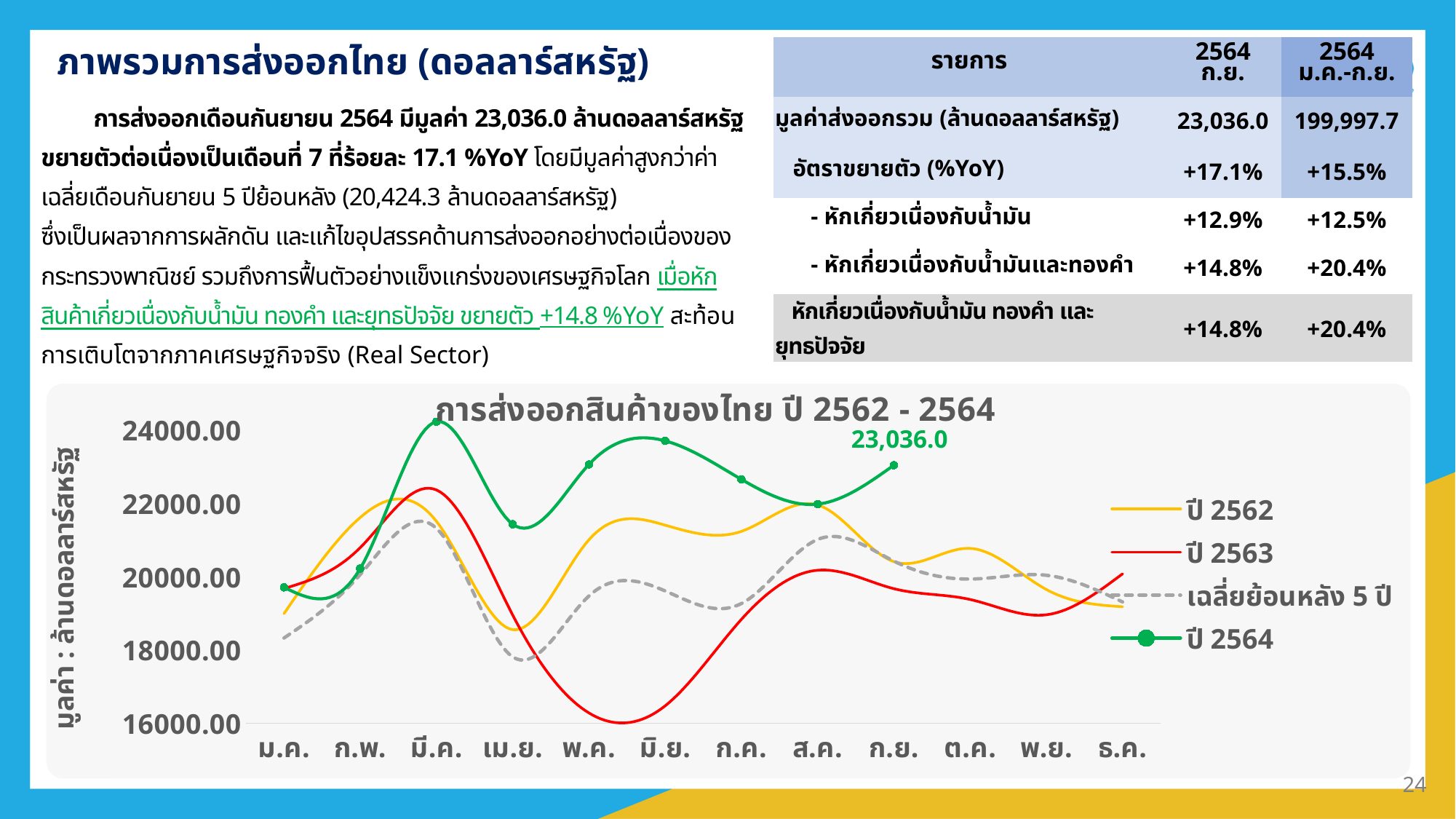
Is the value for ปี 2562 in เม.ย. greater or less than 20000? less What is the title of the chart? การส่งออกสินค้าของไทย ปี 2562 - 2564 Is the value for ปี 2564 in มี.ค. greater or less than 22000? greater In which month does the ปี 2564 series reach its highest value? มี.ค. What is the value for ปี 2564 in ก.ย. according to the data label on the chart? 23,036.0 In ก.ย., which series has the higher value: ปี 2564 or ปี 2563? ปี 2564 Is the value for ปี 2563 in มิ.ย. greater or less than 18000? less How many series does the legend of the chart list? 4 Does the ปี 2564 series rise or fall from เม.ย. to มิ.ย.? rise What kind of chart is shown on the slide? line chart In which month does the ปี 2563 series reach its lowest value? พ.ค. How many months are shown along the x axis of the chart? 12